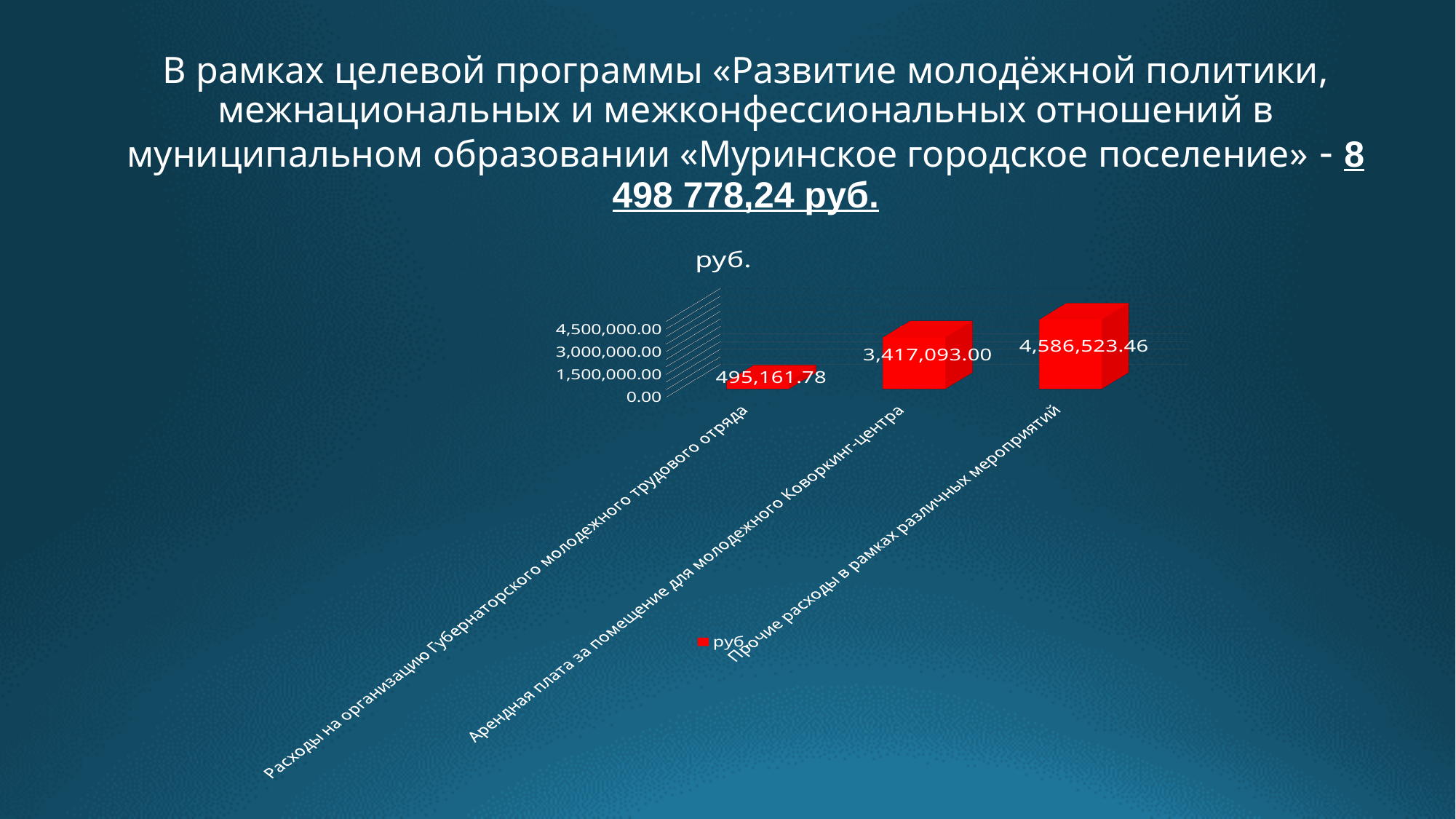
What type of chart is shown on the slide? bar chart Do the values rise or fall from left to right across the categories? rise Which category has the highest value? Прочие расходы в рамках различных мероприятий Which category has the lowest value? Расходы на организацию Губернаторского молодежного трудового отряда What is the title of the chart? руб. How many categories are plotted in the chart? 3 What is the value for "Прочие расходы в рамках различных мероприятий"? 4,586,523.46 What is the difference between the values for "Прочие расходы в рамках различных мероприятий" and "Арендная плата за помещение для молодежного Коворкинг-центра"? 1,169,430.46 Which is larger: the value for "Арендная плата за помещение для молодежного Коворкинг-центра" or the value for "Расходы на организацию Губернаторского молодежного трудового отряда"? Арендная плата за помещение для молодежного Коворкинг-центра What is the value for "Расходы на организацию Губернаторского молодежного трудового отряда"? 495,161.78 What is the value for "Арендная плата за помещение для молодежного Коворкинг-центра"? 3,417,093.00 How many series does the chart legend list? 1